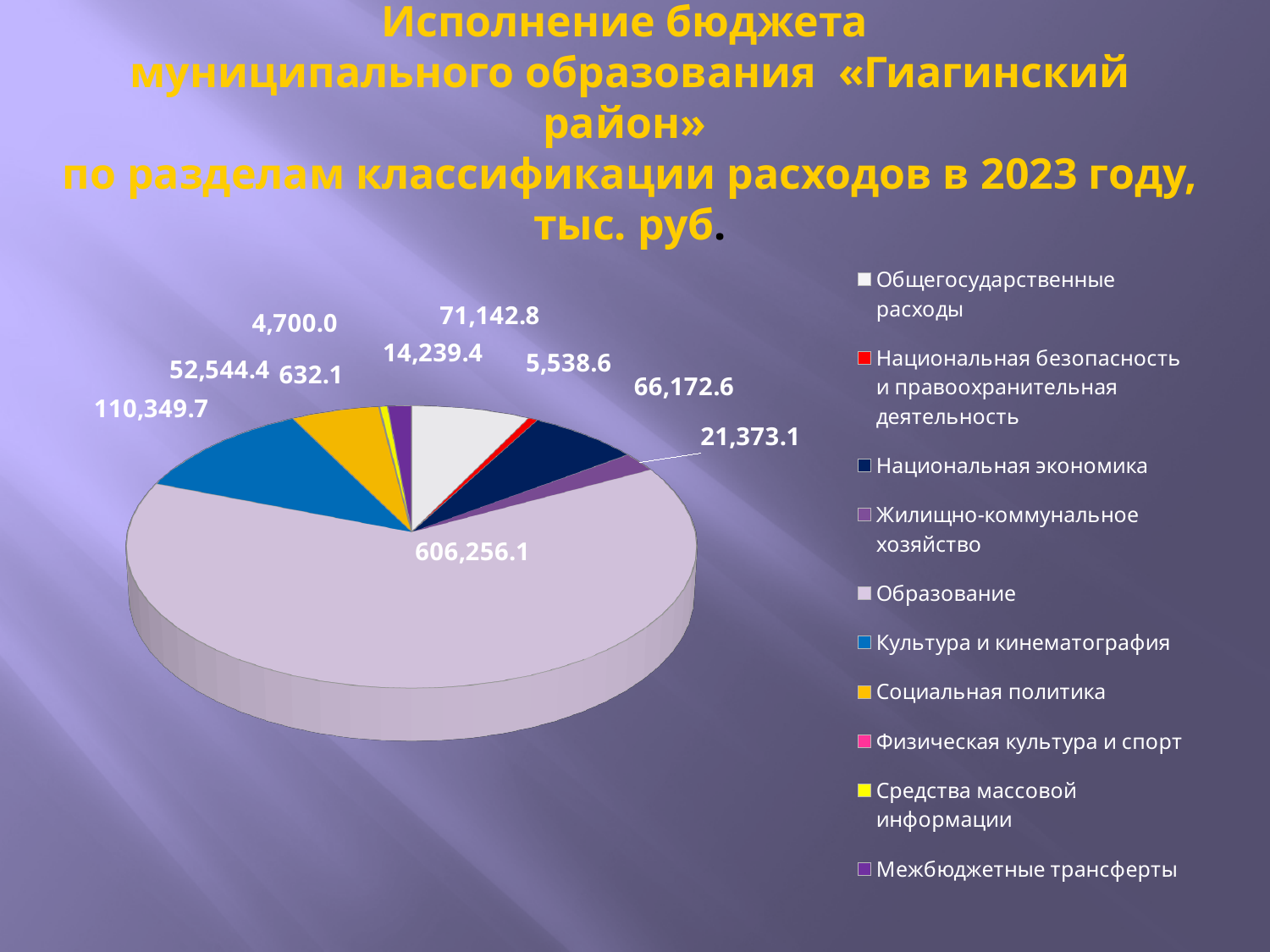
Which category has the largest slice of the pie? Образование What is the value for Культура и кинематография? 110,349.7 What is the value for Общегосударственные расходы? 71,142.8 In what year and units are the budget expenditures shown, according to the title? 2023, тыс. руб. What is the smallest value labelled on the pie chart? 632.1 What is the value for Национальная экономика? 66,172.6 What is the value for Образование? 606,256.1 What kind of chart is shown on the slide? Pie chart How many categories does the legend of the pie chart list? 10 What is the value for Жилищно-коммунальное хозяйство? 21,373.1 What is the difference between the values for Культура и кинематография and Социальная политика? 57,805.3 Which is larger, the value for Общегосударственные расходы or the value for Национальная экономика? Общегосударственные расходы